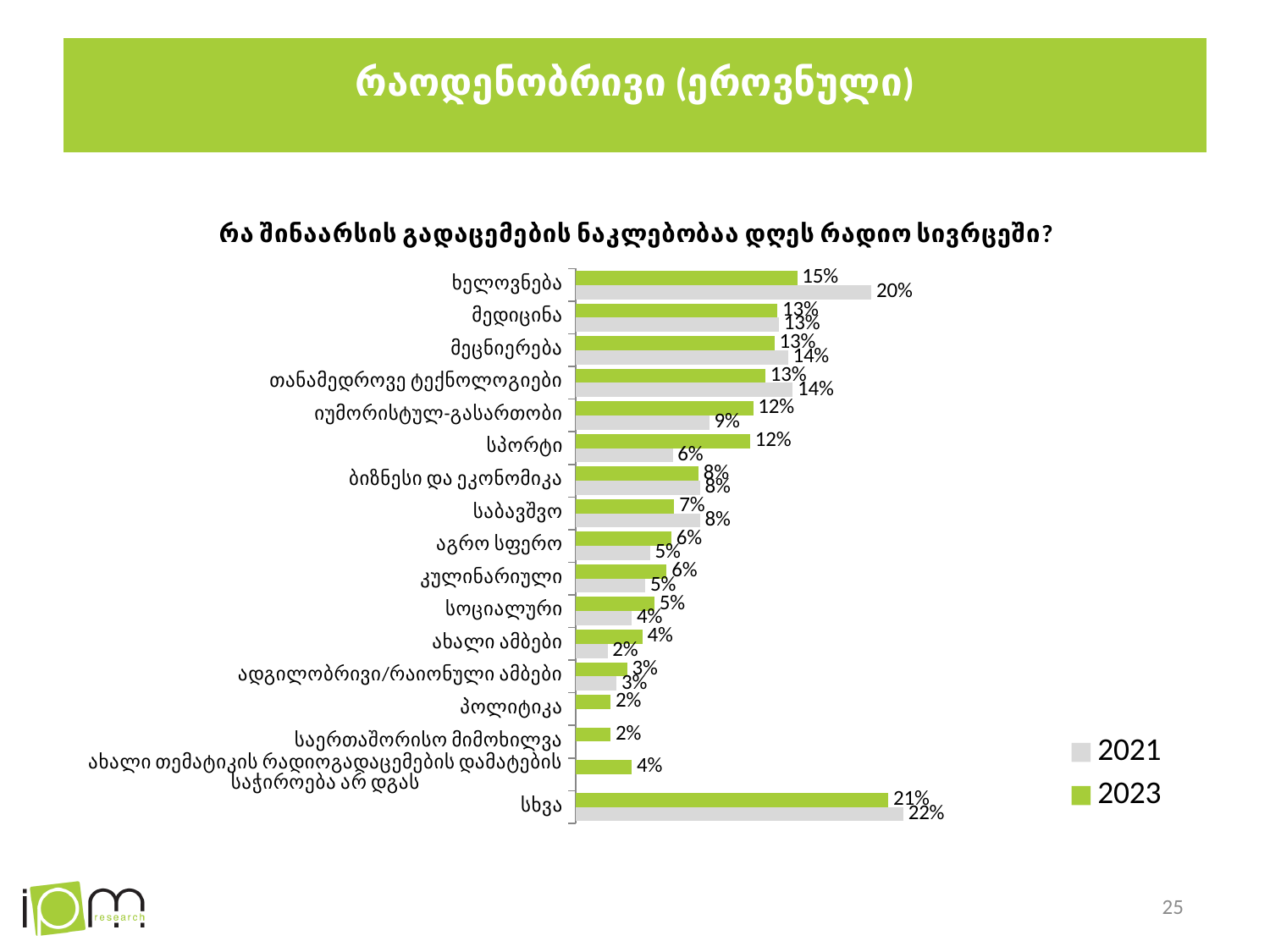
What is the 2021 value for იუმორისტულ-გასართობი? 9% For იუმორისტულ-გასართობი, which is larger: the 2021 value or the 2023 value? 2023 What is the 2023 value for ახალი ამბები? 4% What is the difference between the 2021 and 2023 values for ხელოვნება? 5% How many series does the legend list? 2 How many categories are shown on the chart? 17 What is the 2023 value for სპორტი? 12% Which colour represents the 2023 series in the legend? green What kind of chart is shown on the slide? bar chart What is the 2021 value for ხელოვნება? 20% Which category has the highest 2023 value? სხვა What is the difference between the 2021 and 2023 values for სპორტი? 6%